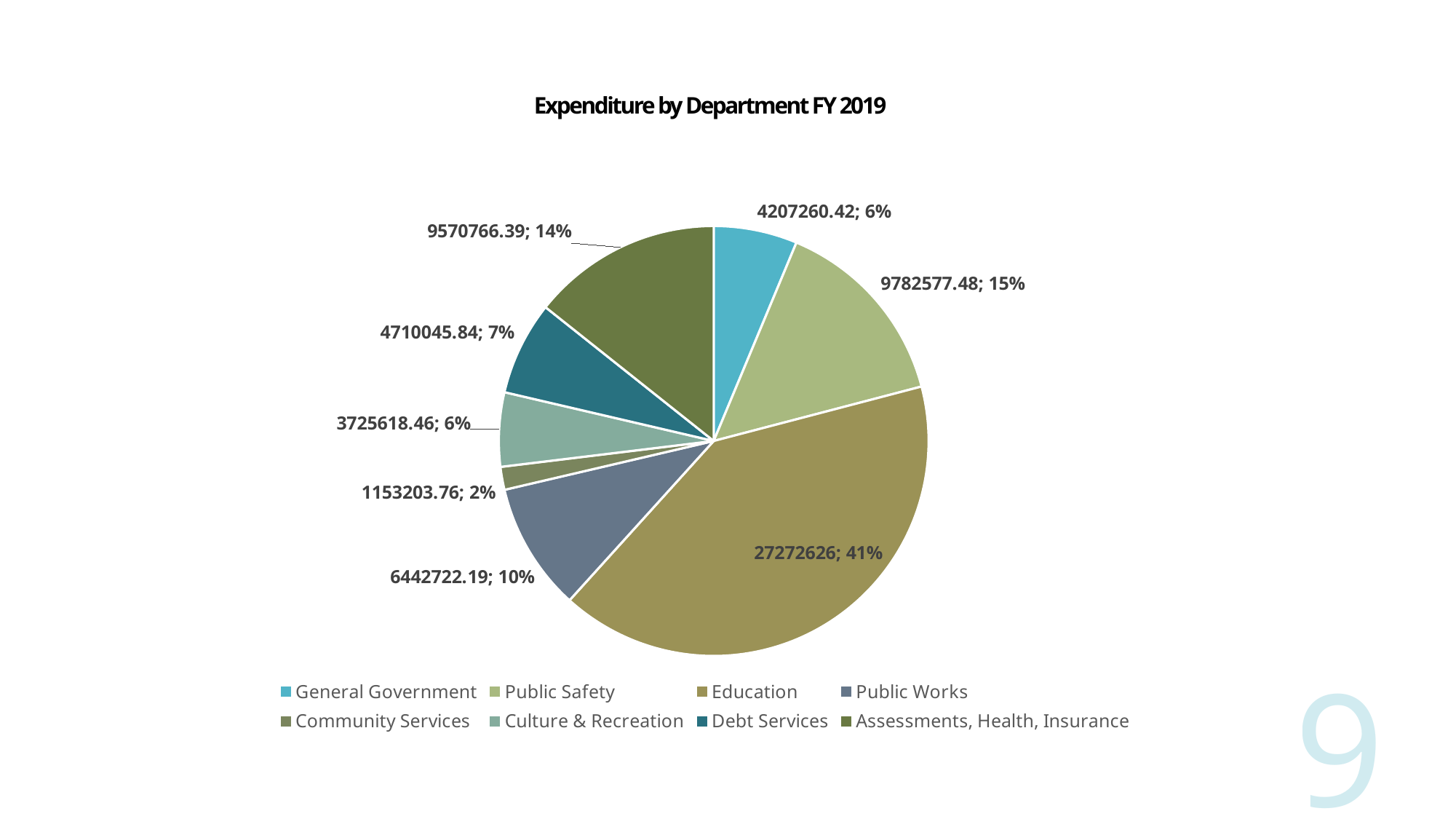
How many departments are shown in the pie chart? 8 What is the value shown for Public Works? 6442722.19 What is the difference in percentage share between Education and Public Safety? 26% Which department has the smallest slice? Community Services What percentage share does Public Safety have? 15% What percentage share does Assessments, Health, Insurance have? 14% What type of chart is shown? Pie chart Which department has the largest slice? Education Which is larger, Public Safety or Public Works? Public Safety What is the value shown for Education? 27272626 What is the value shown for Debt Services? 4710045.84 What is the title of the chart? Expenditure by Department FY 2019